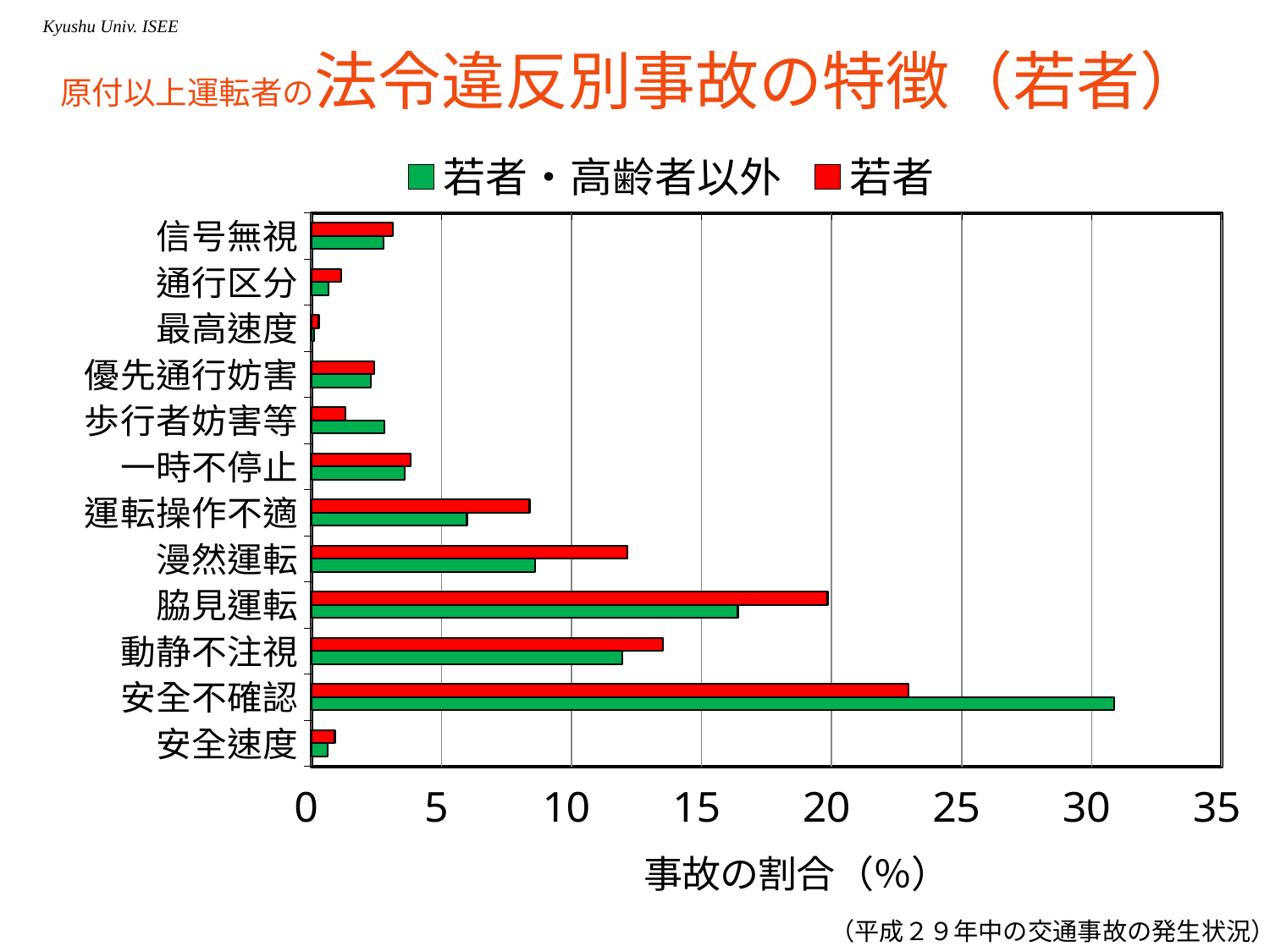
For 安全不確認, which series has the larger value, 若者 or 若者・高齢者以外? 若者・高齢者以外 What is the label of the x axis? 事故の割合（%） How many violation categories are plotted on the y axis? 12 Which category has the lowest value for the 若者 series? 最高速度 Is the value for 安全不確認 in the 若者・高齢者以外 series greater or less than 30? greater For 漫然運転, which series has the larger value, 若者 or 若者・高齢者以外? 若者 Which category has the highest value for the 若者 series? 安全不確認 How many series does the legend list? 2 Is the value for 運転操作不適 in the 若者・高齢者以外 series greater or less than 10? less Is the value for 脇見運転 in the 若者 series greater or less than 15? greater What kind of chart is shown on the slide? bar chart Which category has the highest value for the 若者・高齢者以外 series? 安全不確認